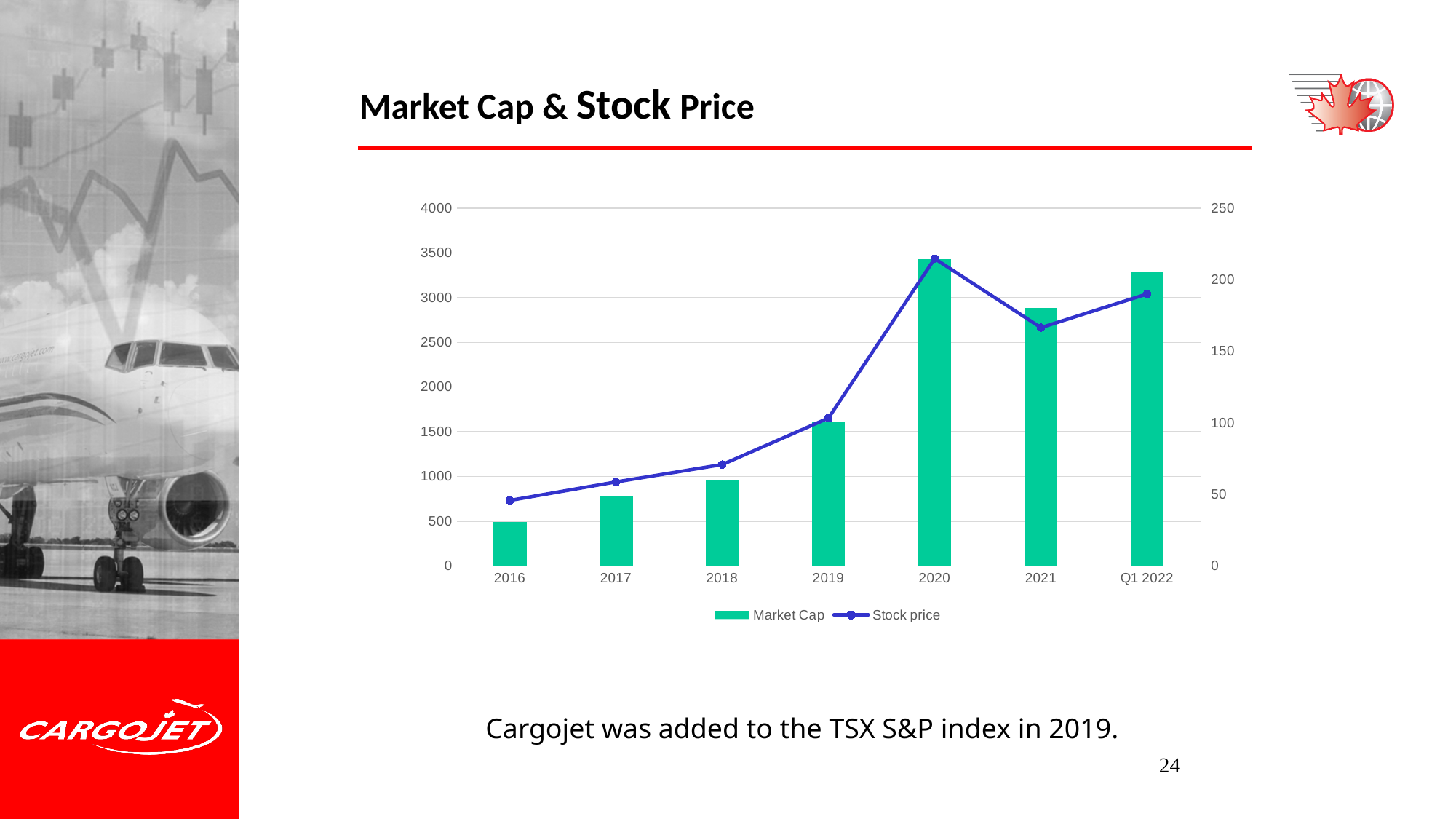
Is the Stock price value for 2020 greater or less than 200? greater Which is larger, the Market Cap for 2021 or for Q1 2022? Q1 2022 What is the title of the chart on the slide? Market Cap & Stock Price What kind of chart is this? Combined bar and line chart How many series does the legend list? 2 Is the Market Cap value for 2019 greater or less than 1500? greater How many categories are shown on the x axis? 7 Which year has the highest Market Cap bar? 2020 Is the Market Cap value for 2021 greater or less than 3000? less What are the two series named in the legend? Market Cap and Stock price Which year has the lowest Market Cap bar? 2016 Which year has the highest Stock price point? 2020